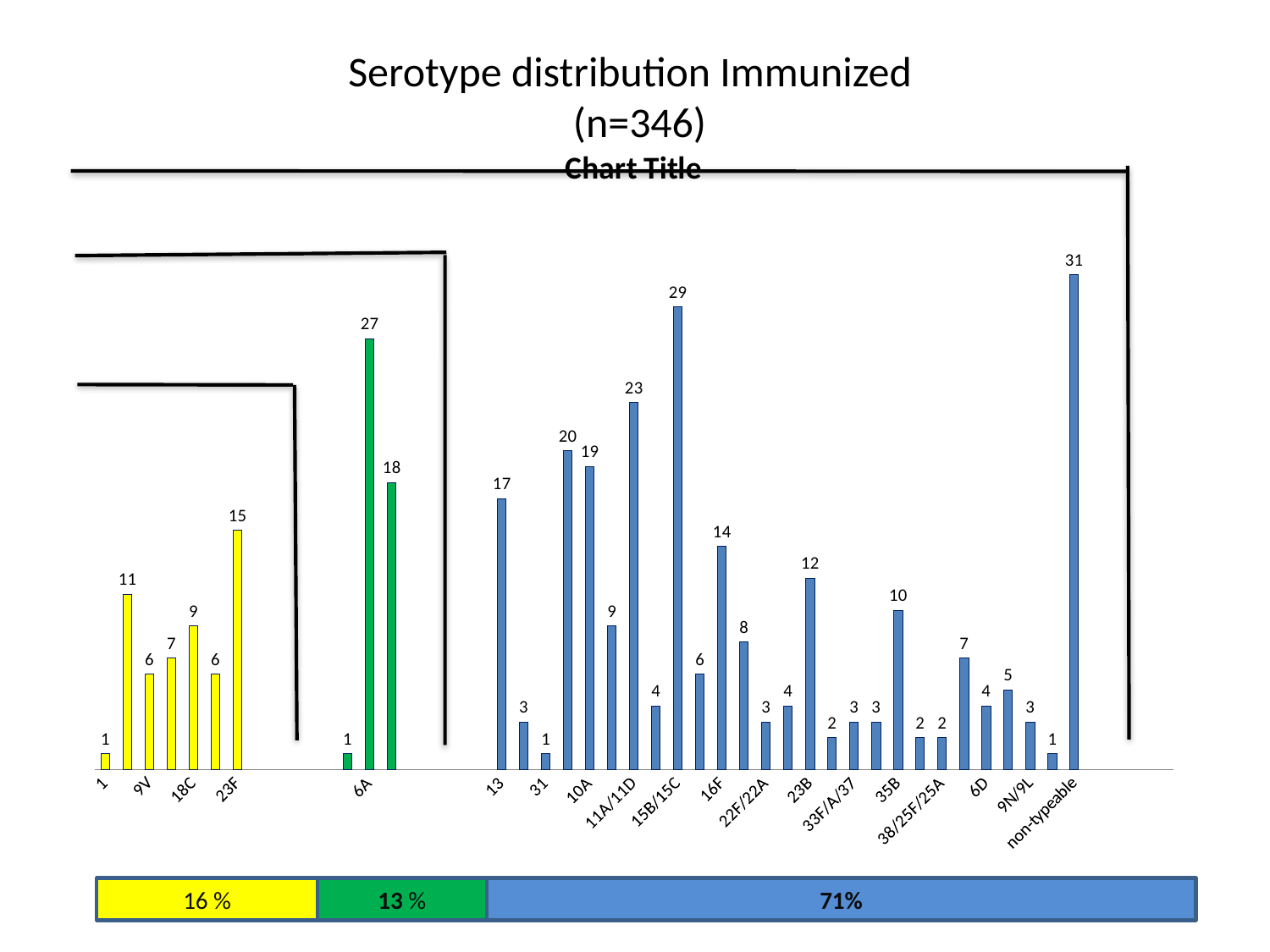
How many yellow bars are there? 7 What is the value for serotype 6A? 27 What percentage is shown in the blue section of the bar at the bottom of the slide? 71% Which is larger, the value for 23F or the value for 18C? 23F Which is larger, the value for 10A or the value for 16F? 10A What is the value for serotype 23F? 15 What is the value for non-typeable? 31 What is the value for serotype 35B? 10 Which category has the highest value? non-typeable What is the difference between the values for 15B/15C and 11A/11D? 6 What is the value for serotype 15B/15C? 29 What kind of chart is shown? bar chart